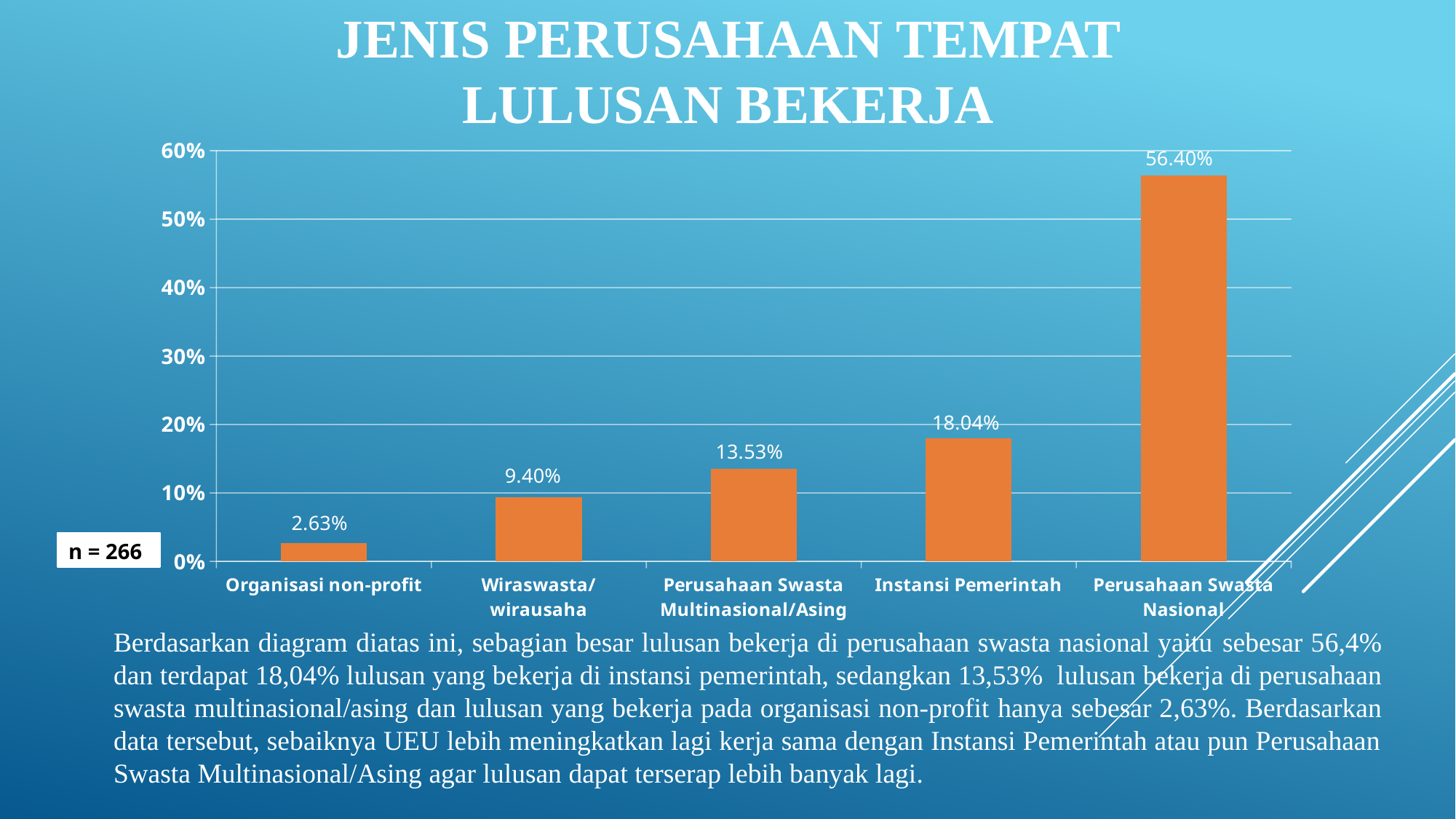
What is the value for Instansi Pemerintah? 18.04% Which category has the lowest value? Organisasi non-profit What is the value for Organisasi non-profit? 2.63% What is the value for Wiraswasta/wirausaha? 9.40% What is the title of the chart? JENIS PERUSAHAAN TEMPAT LULUSAN BEKERJA Which category has the highest value? Perusahaan Swasta Nasional Which is larger, the value for Perusahaan Swasta Multinasional/Asing or the value for Wiraswasta/wirausaha? Perusahaan Swasta Multinasional/Asing What is the value for Perusahaan Swasta Nasional? 56.40% What kind of chart is shown on the slide? bar chart Is the value for Instansi Pemerintah greater or less than 20%? less What is the difference between the values for Perusahaan Swasta Nasional and Instansi Pemerintah? 38.36% How many categories are shown on the chart? 5